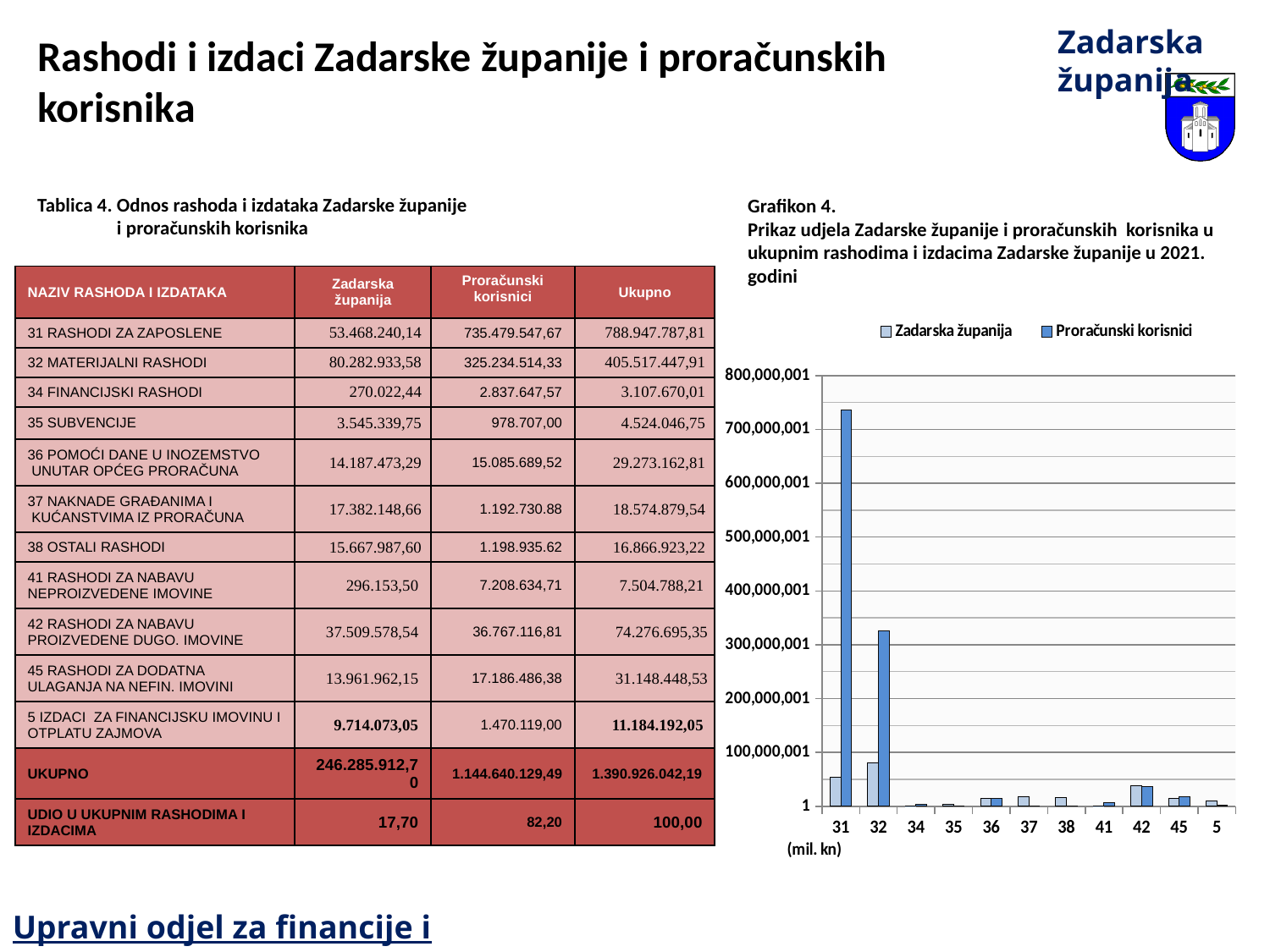
What kind of chart is Grafikon 4? bar chart In Grafikon 4, which category has the highest value for Proračunski korisnici? 31 In Grafikon 4, is the Zadarska županija value for category 32 greater or less than 100,000,001? less In Grafikon 4, is the Proračunski korisnici value for category 32 greater or less than 400,000,001? less What are the two legend entries in Grafikon 4? Zadarska županija and Proračunski korisnici How many categories are shown on the x axis of Grafikon 4? 11 In Grafikon 4, which category has the highest value for Zadarska županija? 32 In Grafikon 4, is the Proračunski korisnici value for category 32 greater or less than 300,000,001? greater In Grafikon 4, for category 31, which series has the larger value: Zadarska županija or Proračunski korisnici? Proračunski korisnici In Grafikon 4, for category 32, which series has the larger value: Zadarska županija or Proračunski korisnici? Proračunski korisnici How many series does the legend of Grafikon 4 list? 2